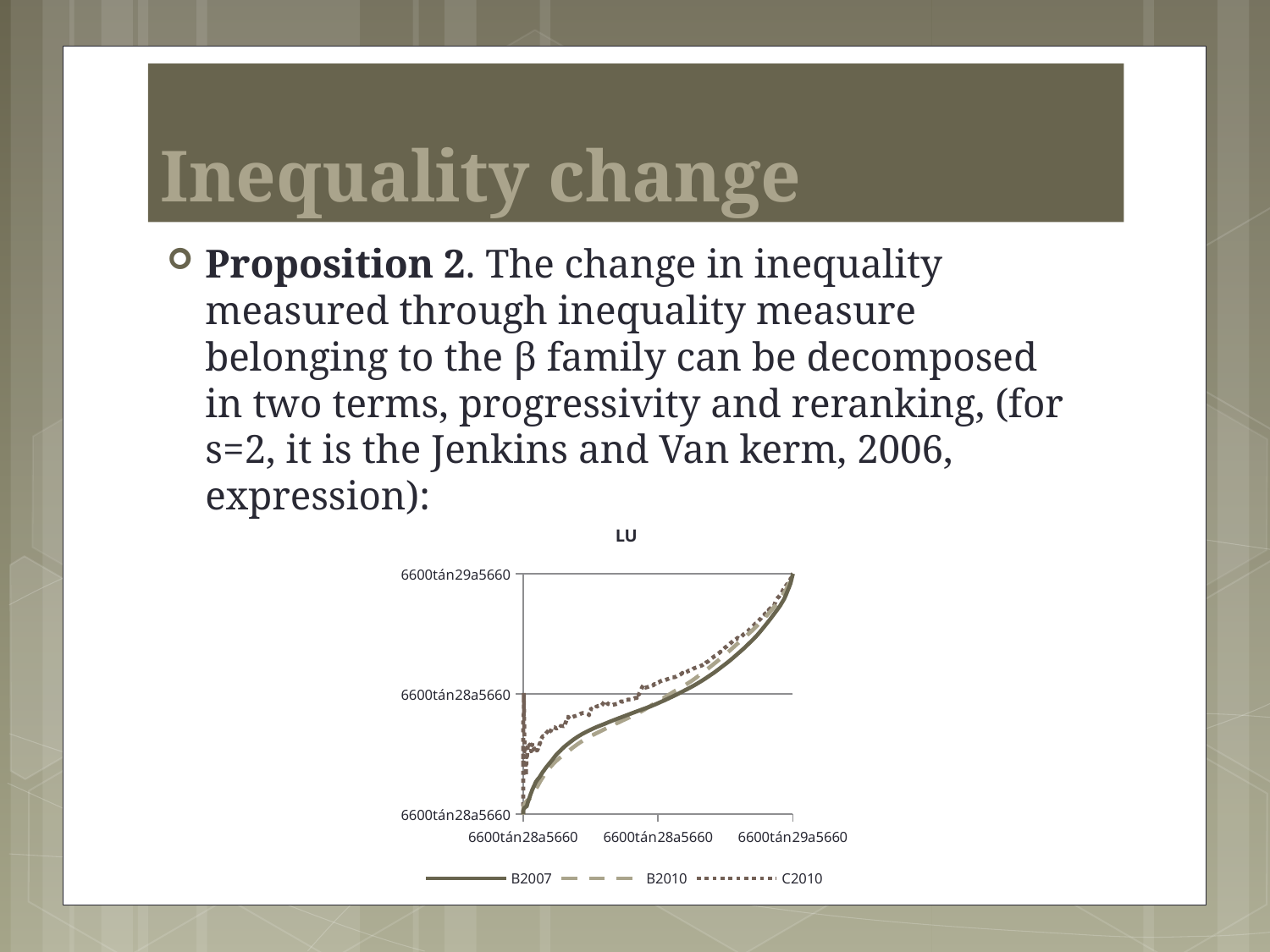
What is the title of the chart? LU Do the plotted lines rise or fall as you move from left to right along the x axis? rise How many series does the legend of the chart list? 3 In the middle portion of the chart, which series lies higher: C2010 or B2007? C2010 Which series in the chart is drawn with a dotted line? C2010 What kind of chart is shown on the slide? line chart